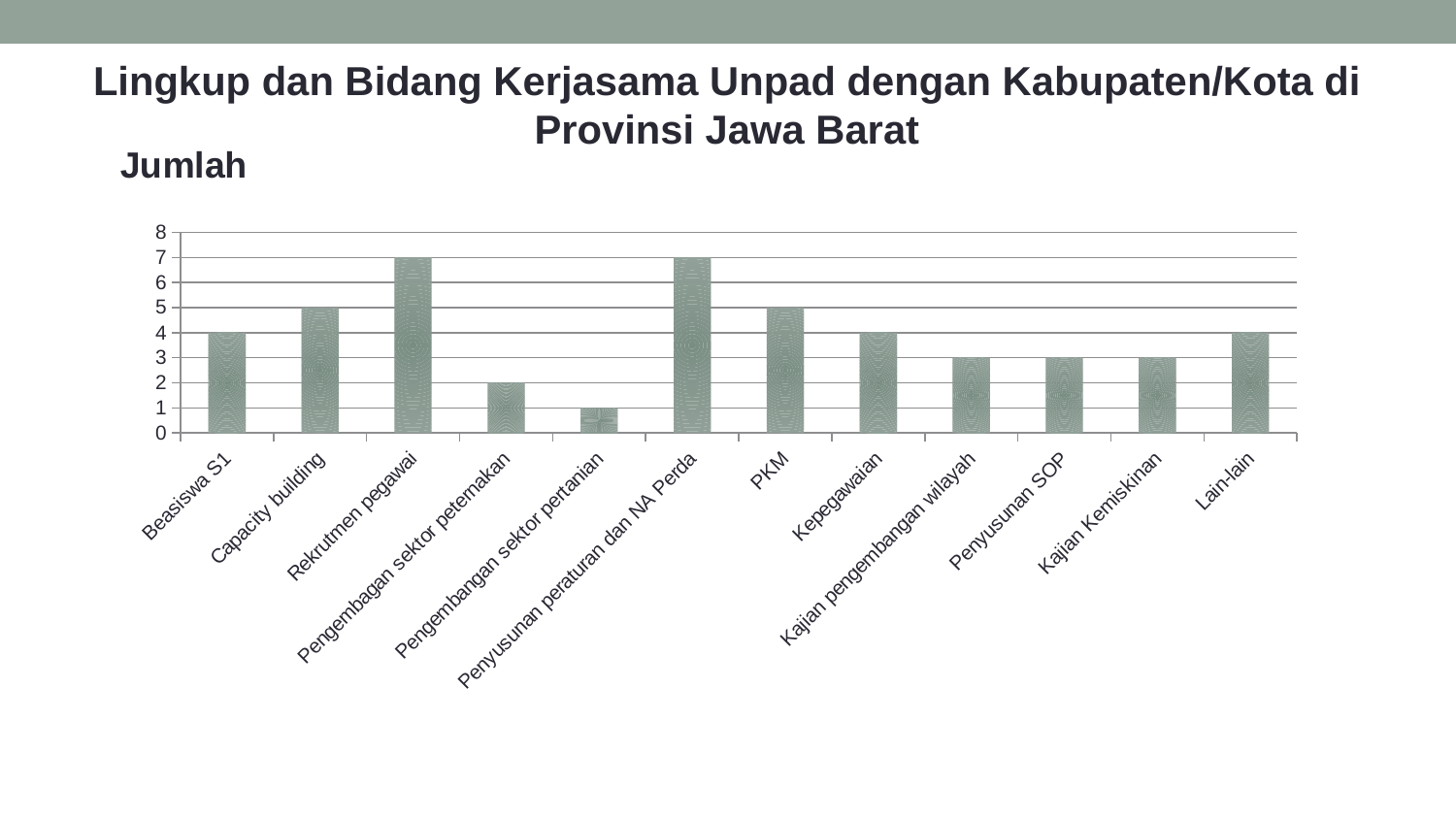
Is the value for Penyusunan peraturan dan NA Perda greater or less than 5? greater What is the value for Capacity building? 5 What is the value for Pengembagan sektor peternakan? 2 Which category has the lowest value in the chart? Pengembangan sektor pertanian What is the title of the chart? Jumlah What kind of chart is shown on the slide? bar chart How many categories are shown on the x axis of the chart? 12 What is the value for Rekrutmen pegawai? 7 What is the label shown above the chart's vertical axis? Jumlah What is the difference between the value for PKM and the value for Penyusunan SOP? 2 What is the value for Pengembangan sektor pertanian? 1 Which is larger, the value for Capacity building or the value for Beasiswa S1? Capacity building